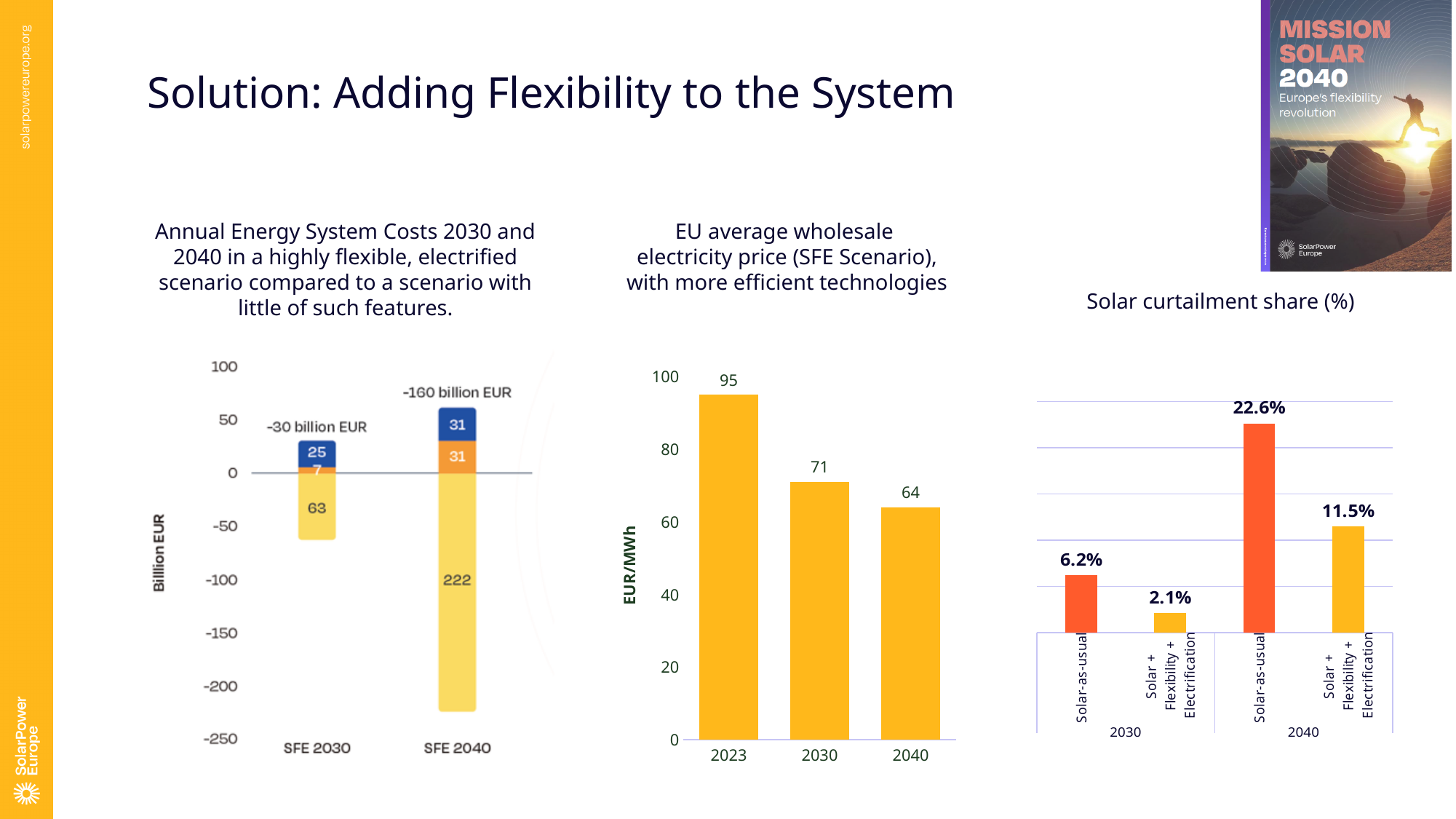
In the Annual Energy System Costs chart, what is the value of the largest yellow segment for SFE 2040? 222 In the EU average wholesale electricity price chart, do the values rise or fall from 2023 to 2040? fall In the Annual Energy System Costs chart, what is the net value labelled above the SFE 2040 bar? -160 billion EUR In the Solar curtailment share chart, which bar is the highest? Solar-as-usual 2040 In the EU average wholesale electricity price chart, what is the difference between the 2023 and 2030 values? 24 In the EU average wholesale electricity price chart, how many years are plotted? 3 In the EU average wholesale electricity price chart, what is the value for 2040? 64 In the Solar curtailment share chart, what is the value for Solar-as-usual in 2040? 22.6% In the EU average wholesale electricity price chart, what is the value for 2023? 95 In the Solar curtailment share chart, what is the difference between Solar-as-usual and Solar + Flexibility + Electrification in 2040? 11.1% In the EU average wholesale electricity price chart, which year has the lowest price? 2040 In the Solar curtailment share chart, what is the value for Solar + Flexibility + Electrification in 2030? 2.1%